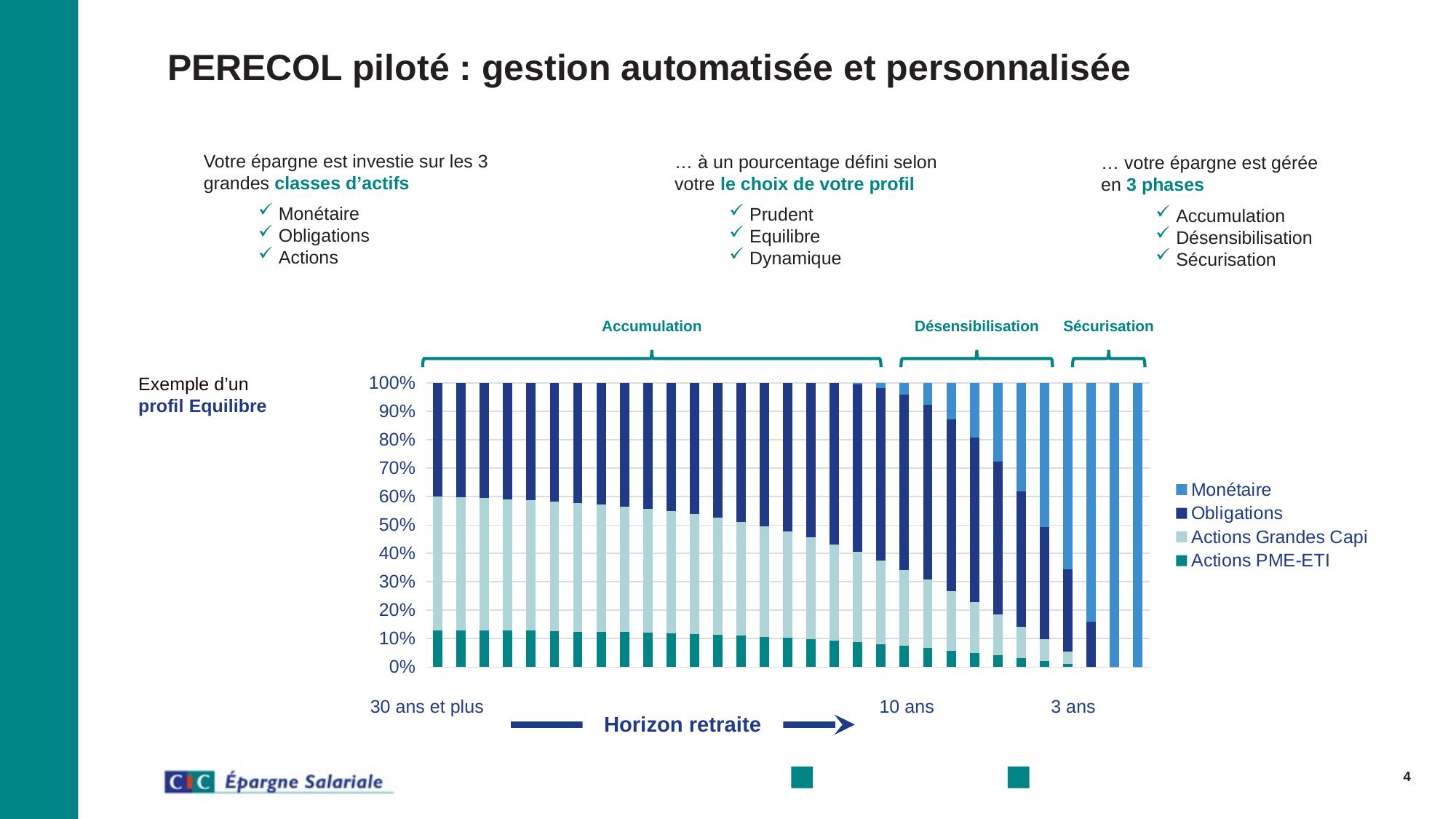
In the '30 ans et plus' bar, is the share of Actions PME-ETI greater or less than 10%? greater How many series does the chart legend list? 4 In the rightmost bar of the chart, is the share of Monétaire greater or less than 90%? greater Which series makes up the largest share of the rightmost bar? Monétaire In the '30 ans et plus' bar, which is larger: the share of Actions Grandes Capi or the share of Actions PME-ETI? Actions Grandes Capi Does the share of Monétaire rise or fall as the bars move from '30 ans et plus' toward the right of the chart? Rise What are the three phases labelled above the chart? Accumulation, Désensibilisation, Sécurisation Which series are listed in the chart legend? Monétaire, Obligations, Actions Grandes Capi, Actions PME-ETI In the '30 ans et plus' bar, which is larger: the share of Obligations or the share of Actions PME-ETI? Obligations What kind of chart is shown on the slide? Stacked bar chart Does the share of Actions PME-ETI rise or fall as the bars move from left to right along the x axis? Fall What is the highest value shown on the chart's y axis? 100%